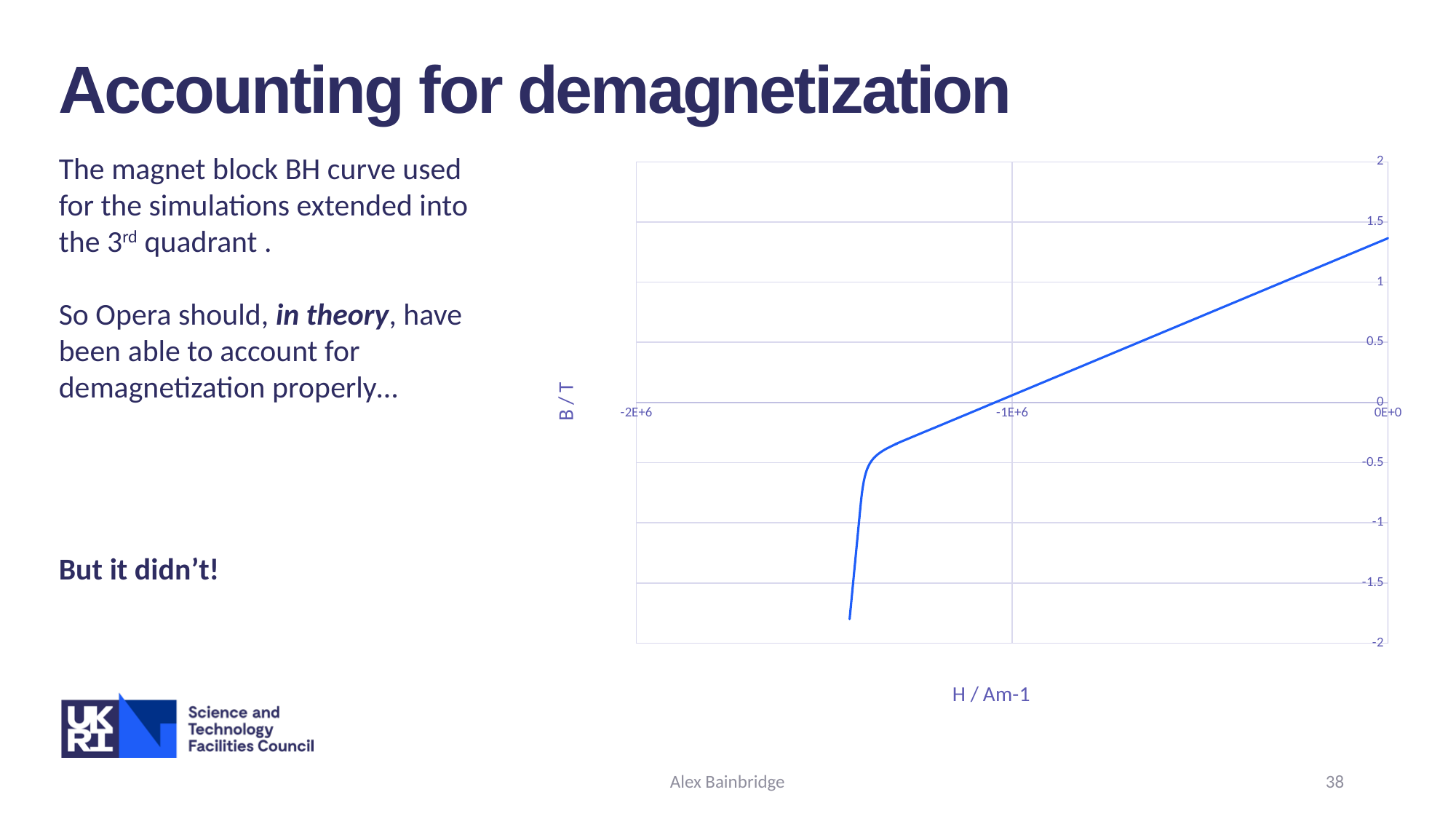
Does the value of B rise or fall as H increases from -2E+6 to 0E+0? rise What is the label of the x axis of the chart? H / Am-1 Is the value of B at H = 0E+0 greater or less than 1.5? less Is the value of B at H = 0E+0 greater or less than 1? greater Is the lowest value of B on the curve greater or less than -1.5? less Which is larger, the value of B at H = 0E+0 or at H = -1E+6? H = 0E+0 What is the maximum value shown on the y axis of the chart? 2 What kind of chart is shown on the slide? line chart What is the label of the y axis of the chart? B / T